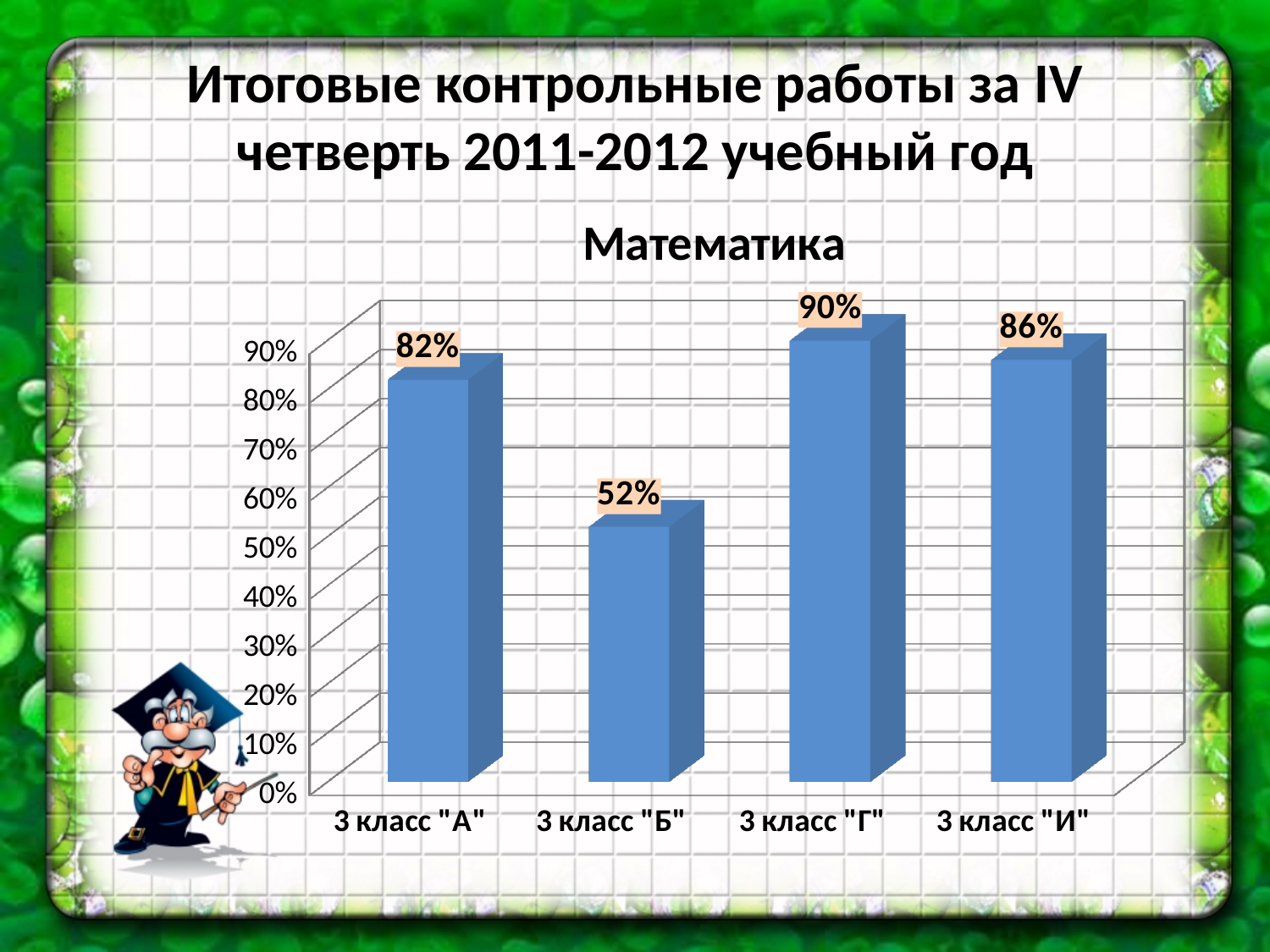
What is the value for 3 класс "Б"? 52% What is the value for 3 класс "Г"? 90% What is the value for 3 класс "И"? 86% Which class has the lowest value? 3 класс "Б" What kind of chart is this? bar chart Which class has the highest value? 3 класс "Г" What is the difference between the values for 3 класс "И" and 3 класс "А"? 4% What is the value for 3 класс "А"? 82% What is the title of the chart? Математика What is the difference between the values for 3 класс "Г" and 3 класс "Б"? 38% How many classes are shown on the chart? 4 Which is larger, the value for 3 класс "А" or 3 класс "И"? 3 класс "И"